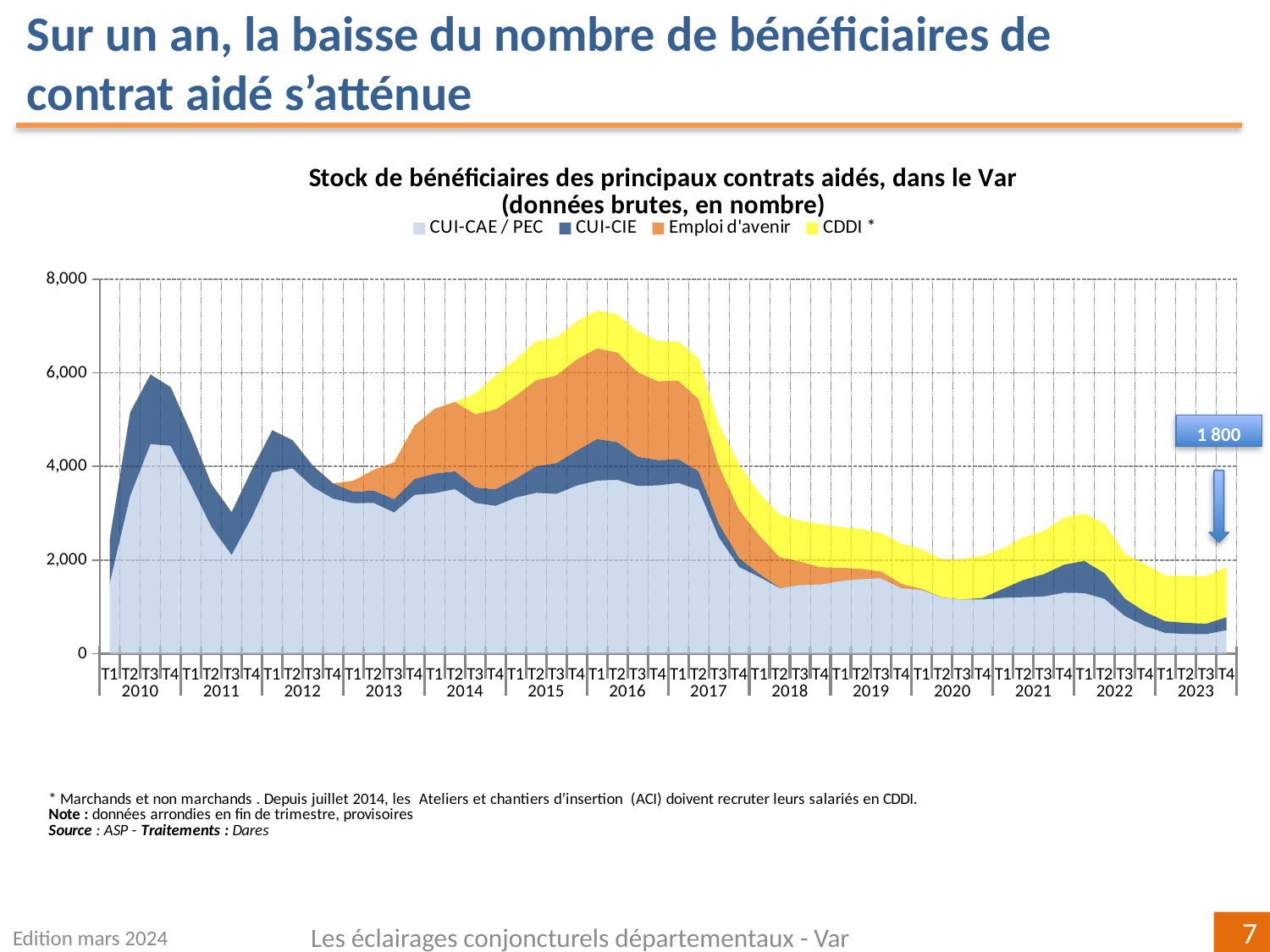
In which year does the total stock of beneficiaries reach its highest peak? 2016 Is the total stock of beneficiaries larger in T1 2016 or in T1 2023? T1 2016 What kind of chart is shown on the slide? Stacked area chart Is the total stock of beneficiaries at T4 2023 greater or less than 2,000? less Is the total stock of beneficiaries at T1 2016 greater or less than 6,000? greater Which colour represents the CDDI * series in the chart? Yellow Does the total stock of beneficiaries rise or fall between T1 2016 and T4 2020? Fall How many years are labelled along the x axis? 14 What value is printed in the callout label at the right end of the chart? 1 800 What is the title of the chart? Stock de bénéficiaires des principaux contrats aidés, dans le Var (données brutes, en nombre) How many series does the legend list? 4